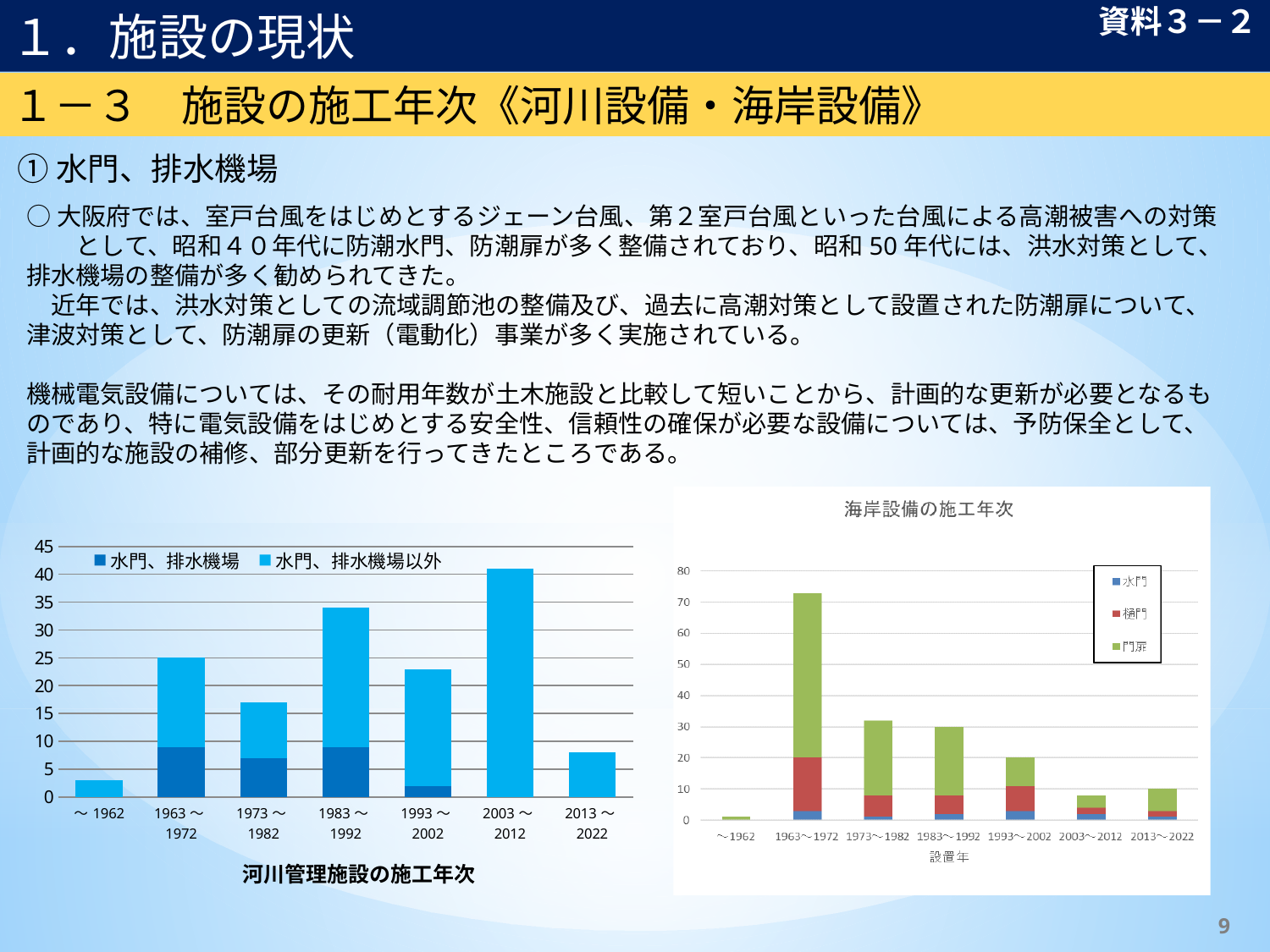
In the 河川管理施設の施工年次 chart, which stacked bar is taller: 1983～1992 or 1993～2002? 1983～1992 What is the x-axis title of the 海岸設備の施工年次 chart? 設置年 In the 海岸設備の施工年次 chart, which period has the tallest stacked bar? 1963～1972 In the 河川管理施設の施工年次 chart, is the total bar for 2003～2012 greater or less than 35? greater In the 河川管理施設の施工年次 chart, which period has the tallest stacked bar? 2003～2012 How many period categories are shown on the x axis of the 河川管理施設の施工年次 chart? 7 How many series does the legend of the 河川管理施設の施工年次 chart list? 2 How many series does the legend of the 海岸設備の施工年次 chart list? 3 In the 海岸設備の施工年次 chart, is the total bar for 1963～1972 greater or less than 60? greater What kind of chart is the 河川管理施設の施工年次 chart on the left? bar chart In the 河川管理施設の施工年次 chart, which period has the shortest stacked bar? ～1962 In the 河川管理施設の施工年次 chart, is the total bar for 2013～2022 greater or less than 10? less